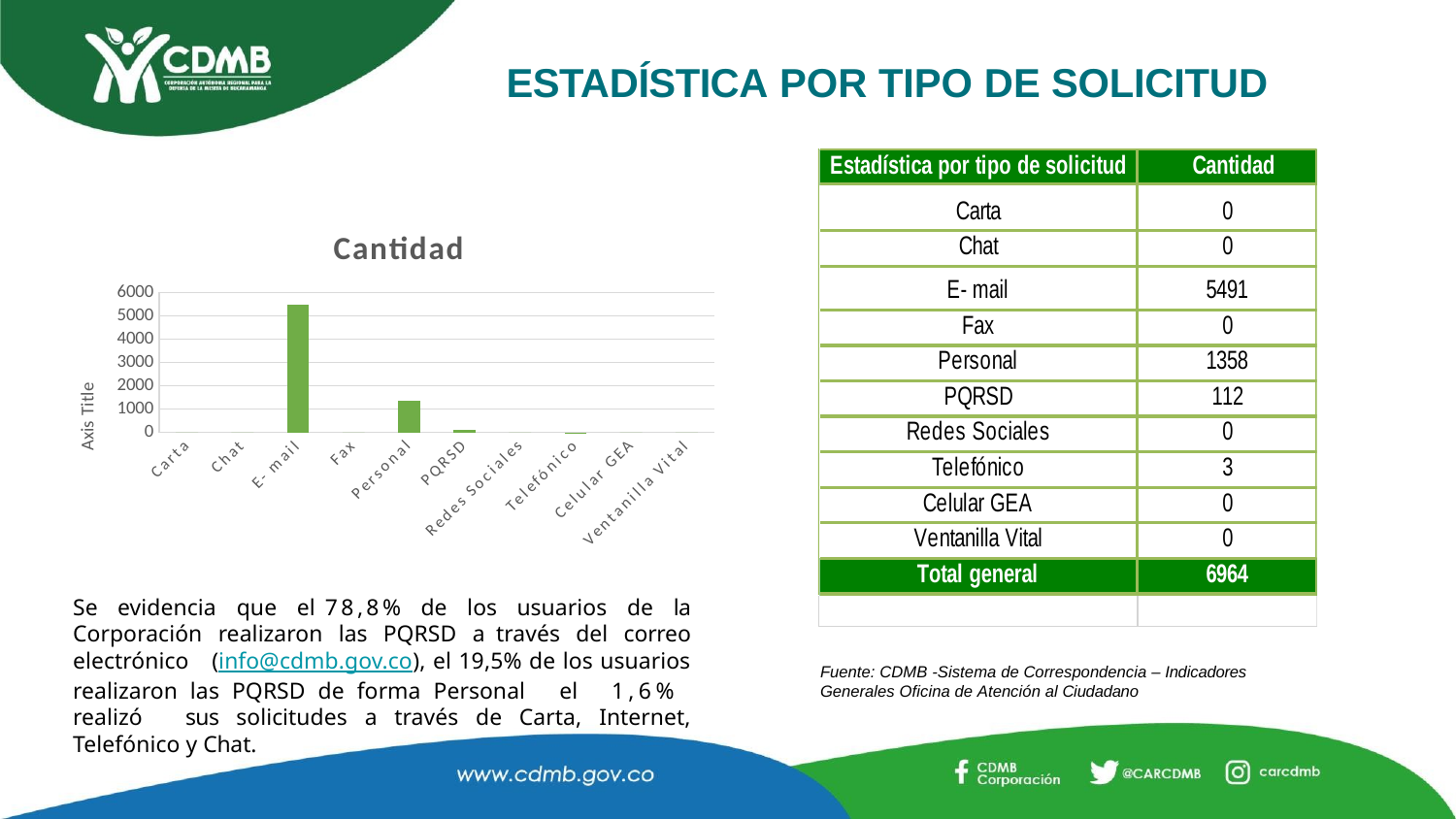
What is the value for Personal? 1358 Is the value for Personal greater or less than 1000? greater What is the value for E- mail? 5491 How many categories are shown on the x axis of the chart? 10 Which is larger, the value for E- mail or the value for Personal? E- mail What is the title of the chart? Cantidad What is the difference between the values for E- mail and Personal? 4133 Is the value for E- mail greater or less than 5000? greater What label is shown on the vertical axis of the chart? Axis Title Which category has the highest value in the chart? E- mail What kind of chart is shown on the slide? bar chart Is the value for PQRSD greater or less than 1000? less